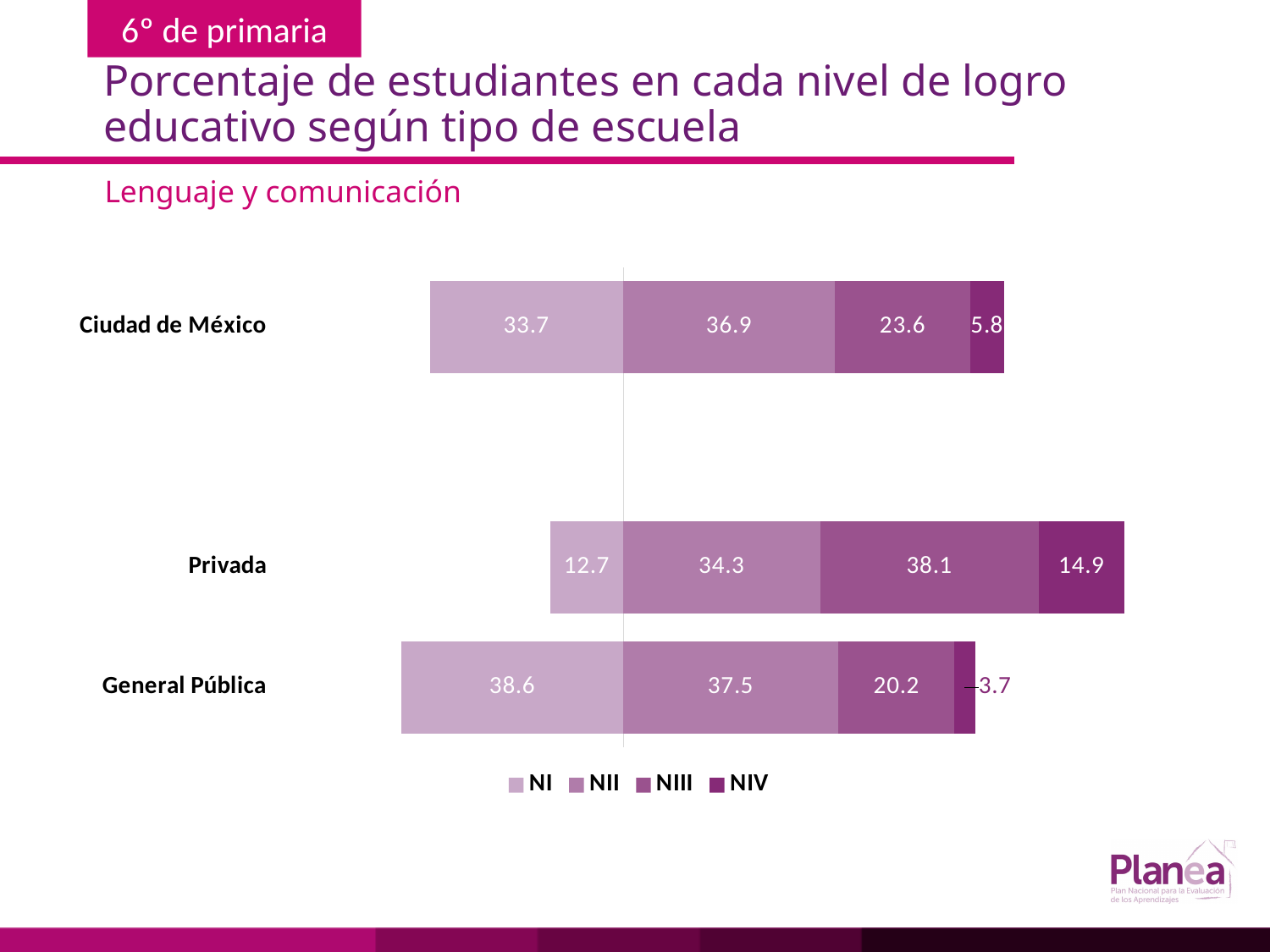
What is the NII value for General Pública? 37.5 How many school types are shown in the chart? 3 What is the NIV value for General Pública? 3.7 What is the total of the stacked bar for Privada? 100.0 Which school type has the lowest NI value? Privada What is the difference between the NI values for General Pública and Ciudad de México? 4.9 What is the NIII value for Ciudad de México? 23.6 How many series does the legend list? 4 What is the NI value for Privada? 12.7 What kind of chart is shown on the slide? Stacked bar chart Which is larger, the NIII value for Privada or the NIII value for General Pública? Privada Which school type has the highest NIV value? Privada